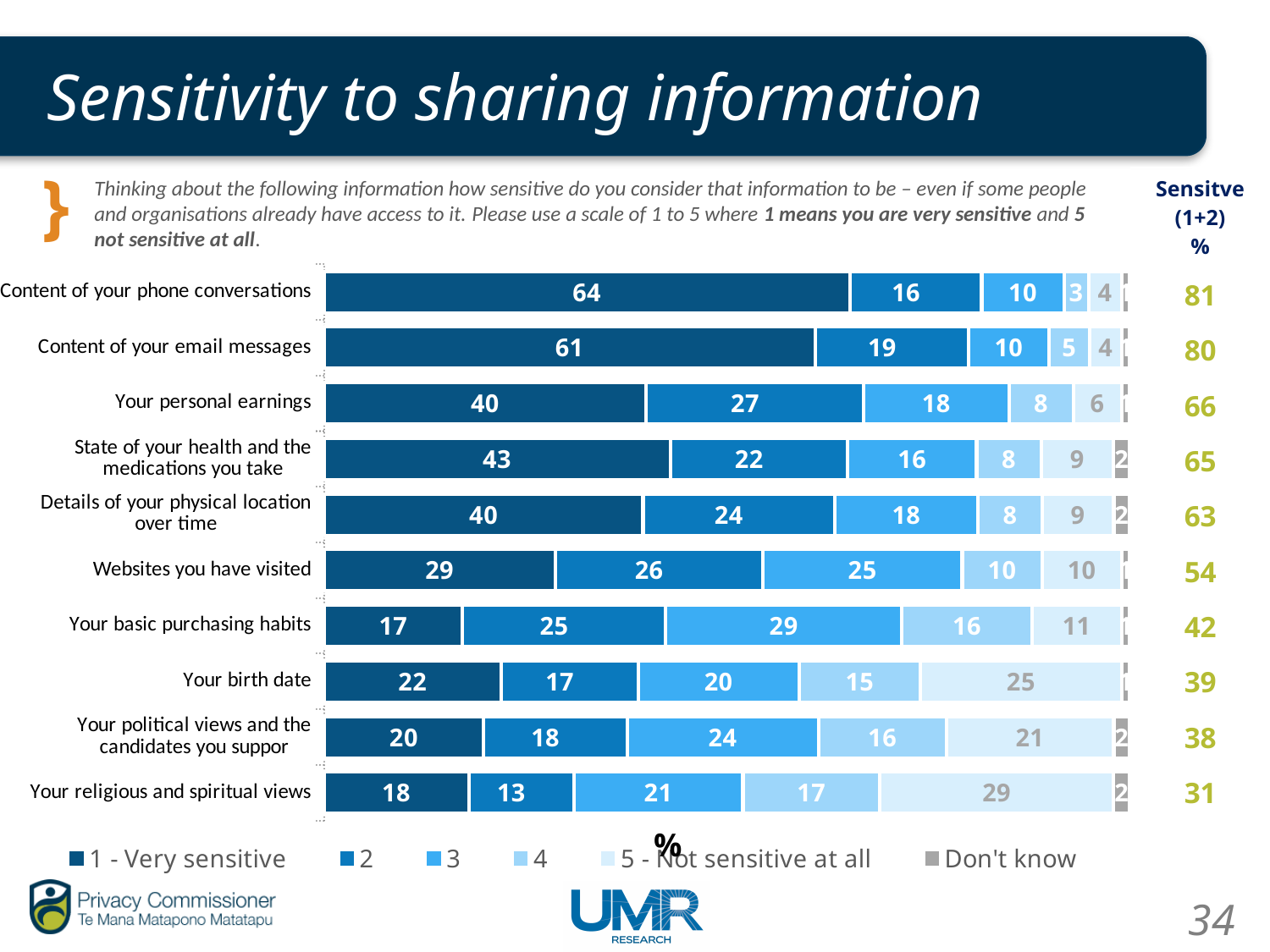
What is the value for series '2' for 'Your personal earnings'? 27 Which is larger: the '1 - Very sensitive' value for 'State of your health and the medications you take' or for 'Websites you have visited'? State of your health and the medications you take What is the '1 - Very sensitive' value for 'Content of your phone conversations'? 64 What kind of chart is shown on the slide? Stacked bar chart Which category has the lowest '1 - Very sensitive' value? Your basic purchasing habits What is the '5 - Not sensitive at all' value for 'Your religious and spiritual views'? 29 What is the difference between the '1 - Very sensitive' values for 'Content of your email messages' and 'Your birth date'? 39 What is the 'Sensitve (1+2) %' value shown for 'Your political views and the candidates you suppor'? 38 How many categories are shown in the chart? 10 What is the title of the slide? Sensitivity to sharing information How many series does the legend list? 6 Which category has the highest '1 - Very sensitive' value? Content of your phone conversations